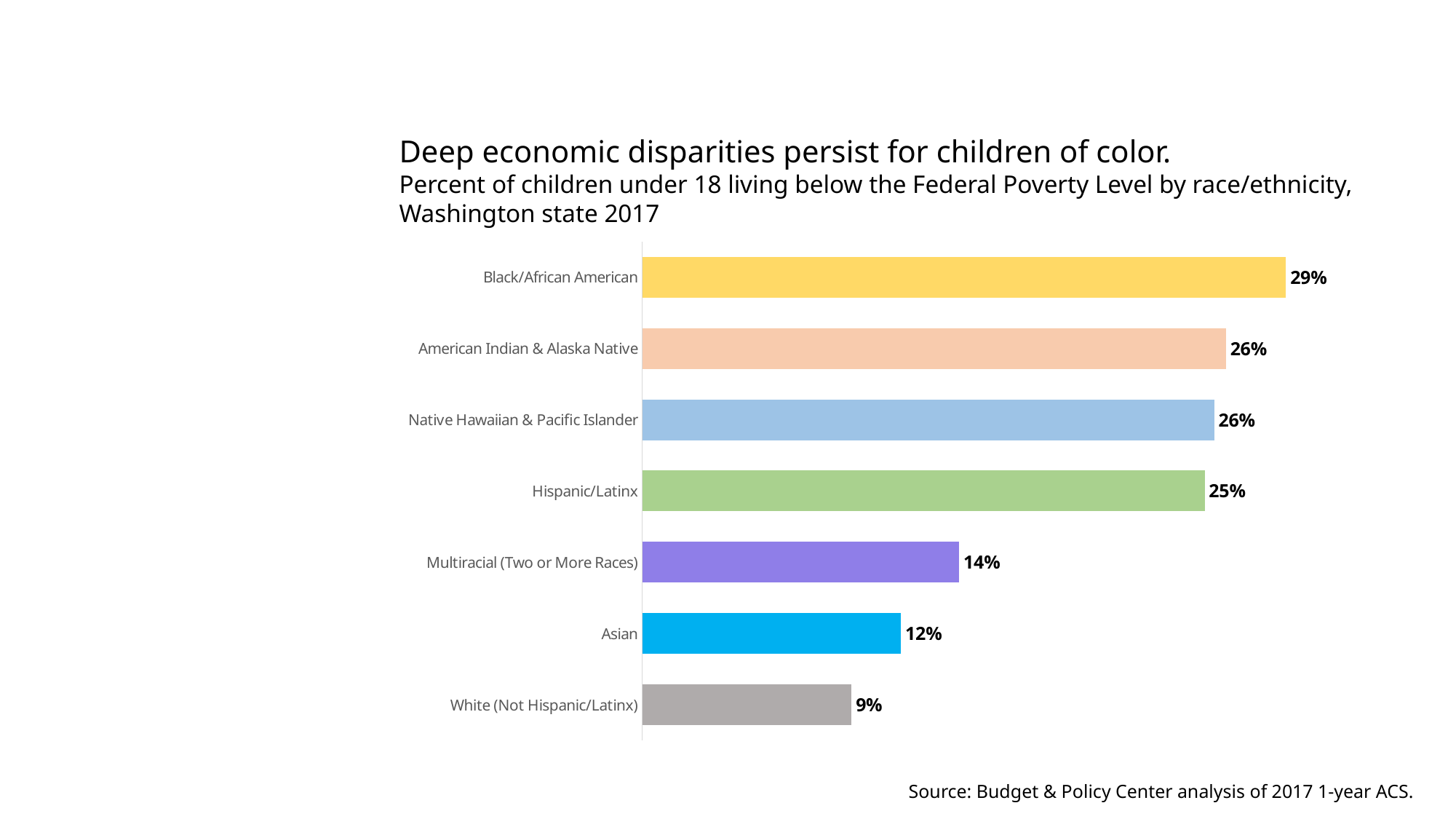
Which category has the highest value? Black/African American Which is larger, the value for Hispanic/Latinx or the value for Asian? Hispanic/Latinx Which category has the lowest value? White (Not Hispanic/Latinx) What is the title of the chart? Deep economic disparities persist for children of color. How many categories are shown in the chart? 7 What is the value for Hispanic/Latinx? 25% What is the value for Black/African American? 29% What is the difference between the values for Black/African American and White (Not Hispanic/Latinx)? 20% What kind of chart is shown on the slide? Bar chart What is the value for Multiracial (Two or More Races)? 14% What is the difference between the values for Multiracial (Two or More Races) and Asian? 2% What is the value for White (Not Hispanic/Latinx)? 9%